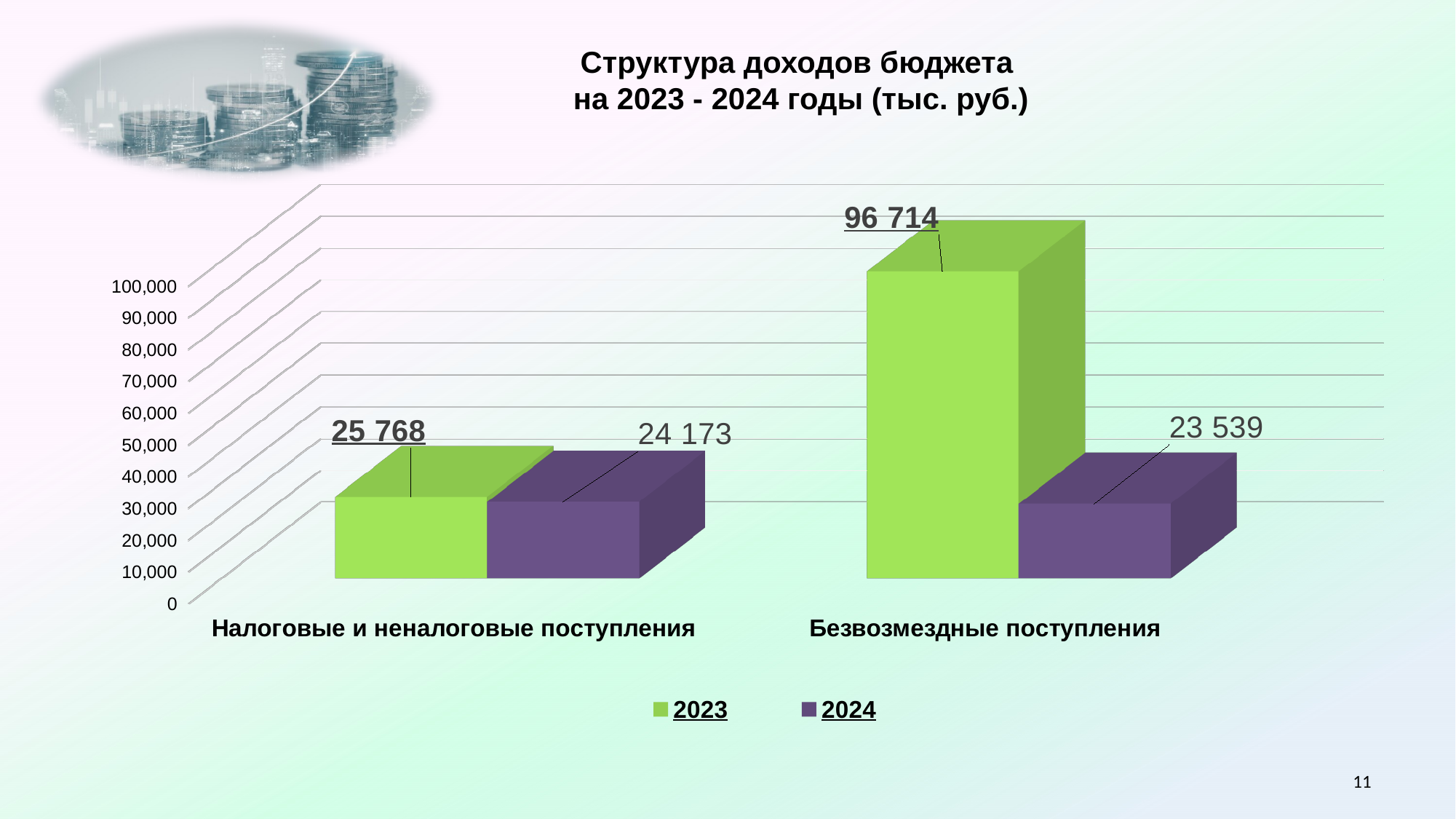
What is the value for 2023 in the category "Безвозмездные поступления"? 96 714 What is the difference between the 2023 and 2024 values for "Безвозмездные поступления"? 73 175 What is the value for 2023 in the category "Налоговые и неналоговые поступления"? 25 768 How many series does the legend list? 2 What is the difference between the 2023 and 2024 values for "Налоговые и неналоговые поступления"? 1 595 Which category has the highest value for the 2023 series? Безвозмездные поступления Which is larger: the 2023 value for "Безвозмездные поступления" or the 2023 value for "Налоговые и неналоговые поступления"? Безвозмездные поступления What is the value for 2024 in the category "Безвозмездные поступления"? 23 539 How many categories are shown on the x axis? 2 What is the value for 2024 in the category "Налоговые и неналоговые поступления"? 24 173 Which category has the lowest value for the 2024 series? Безвозмездные поступления What kind of chart is shown on the slide? Bar chart